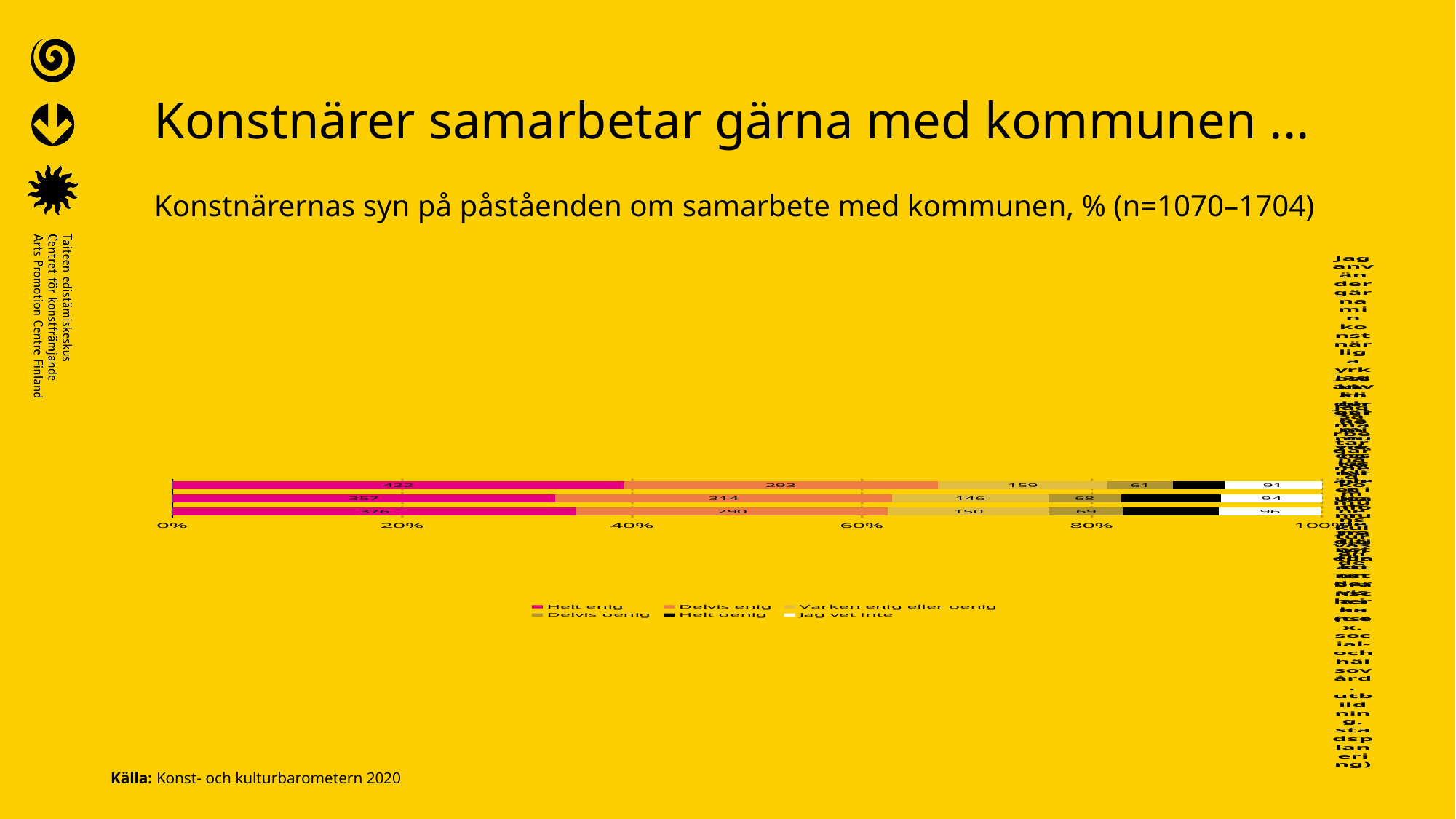
What is the 'Jag vet inte' value for the bottom bar? 96 What is the 'Varken enig eller oenig' value for the top bar? 159 What kind of chart is shown on the slide? bar chart Which bar has the highest 'Helt enig' value? top bar How many bars are plotted in the chart? 3 Which bar has the lowest 'Jag vet inte' value? top bar What is the first entry in the chart legend? Helt enig Which has the larger 'Helt enig' value, the top bar or the middle bar? top bar What is the 'Helt enig' value for the top bar? 422 What is the difference between the 'Helt enig' values of the top bar and the bottom bar? 46 What is the 'Delvis enig' value for the middle bar? 314 How many series does the legend list? 6